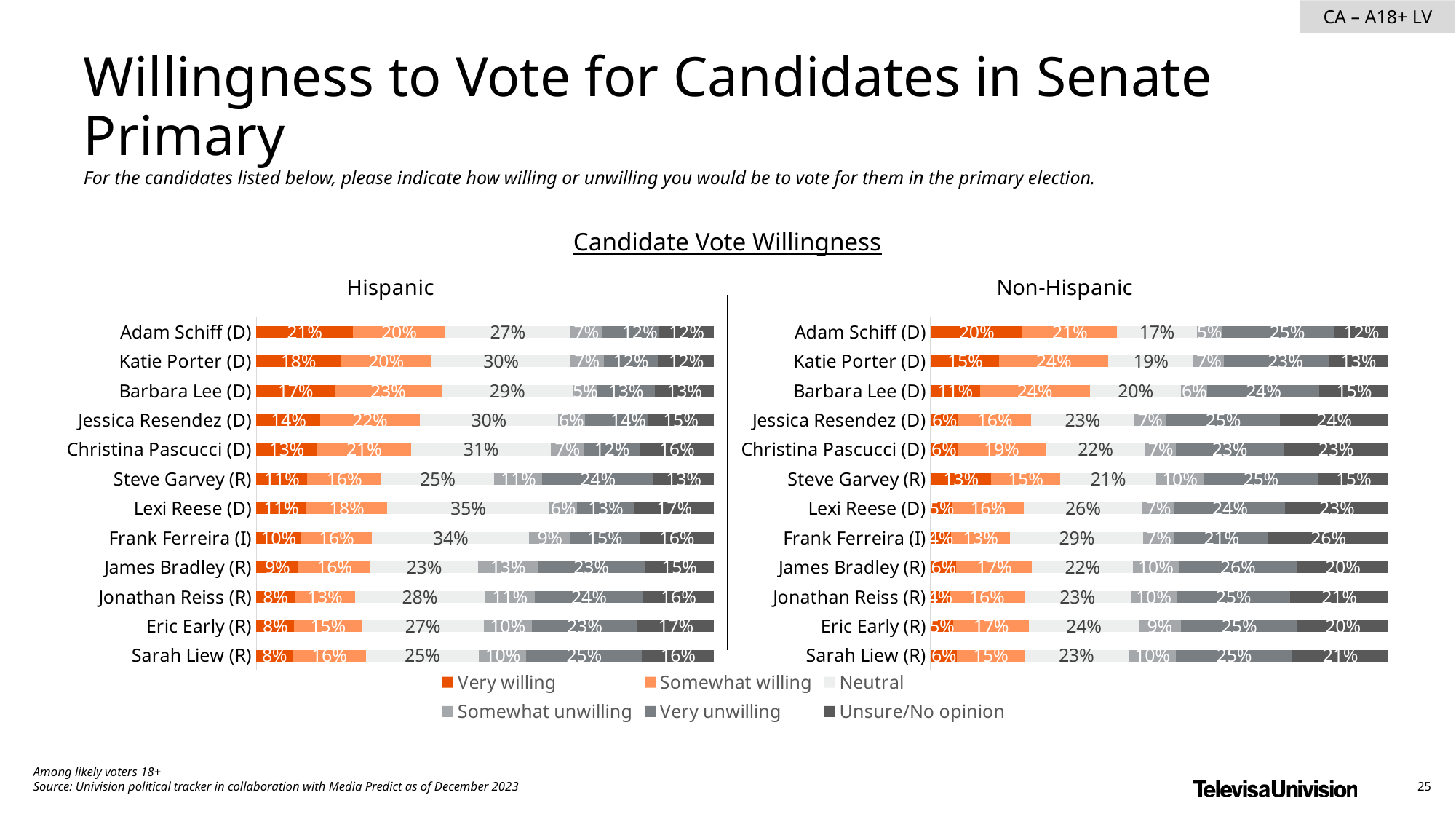
In the Non-Hispanic chart, what percentage of respondents are Neutral on Frank Ferreira (I)? 29% How many series does the legend list for the charts? 6 In the Non-Hispanic chart, which candidate has the highest Very willing percentage? Adam Schiff (D) Is the Very willing percentage for Katie Porter (D) higher in the Hispanic chart or the Non-Hispanic chart? Hispanic In the Hispanic chart, what percentage of respondents are Very willing to vote for Adam Schiff (D)? 21% In the Hispanic chart, what is the Very unwilling percentage for Steve Garvey (R)? 24% In the Non-Hispanic chart, which candidate has the lowest Somewhat willing percentage? Frank Ferreira (I) In the Hispanic chart, what is the difference between the Very willing percentages for Adam Schiff (D) and Sarah Liew (R)? 13 percentage points How many candidates are listed in the Hispanic chart? 12 What type of chart is used to show Candidate Vote Willingness? Stacked bar chart In the Non-Hispanic chart, what is the Unsure/No opinion percentage for Jessica Resendez (D)? 24% In the Hispanic chart, which candidate has the highest Neutral percentage? Lexi Reese (D)